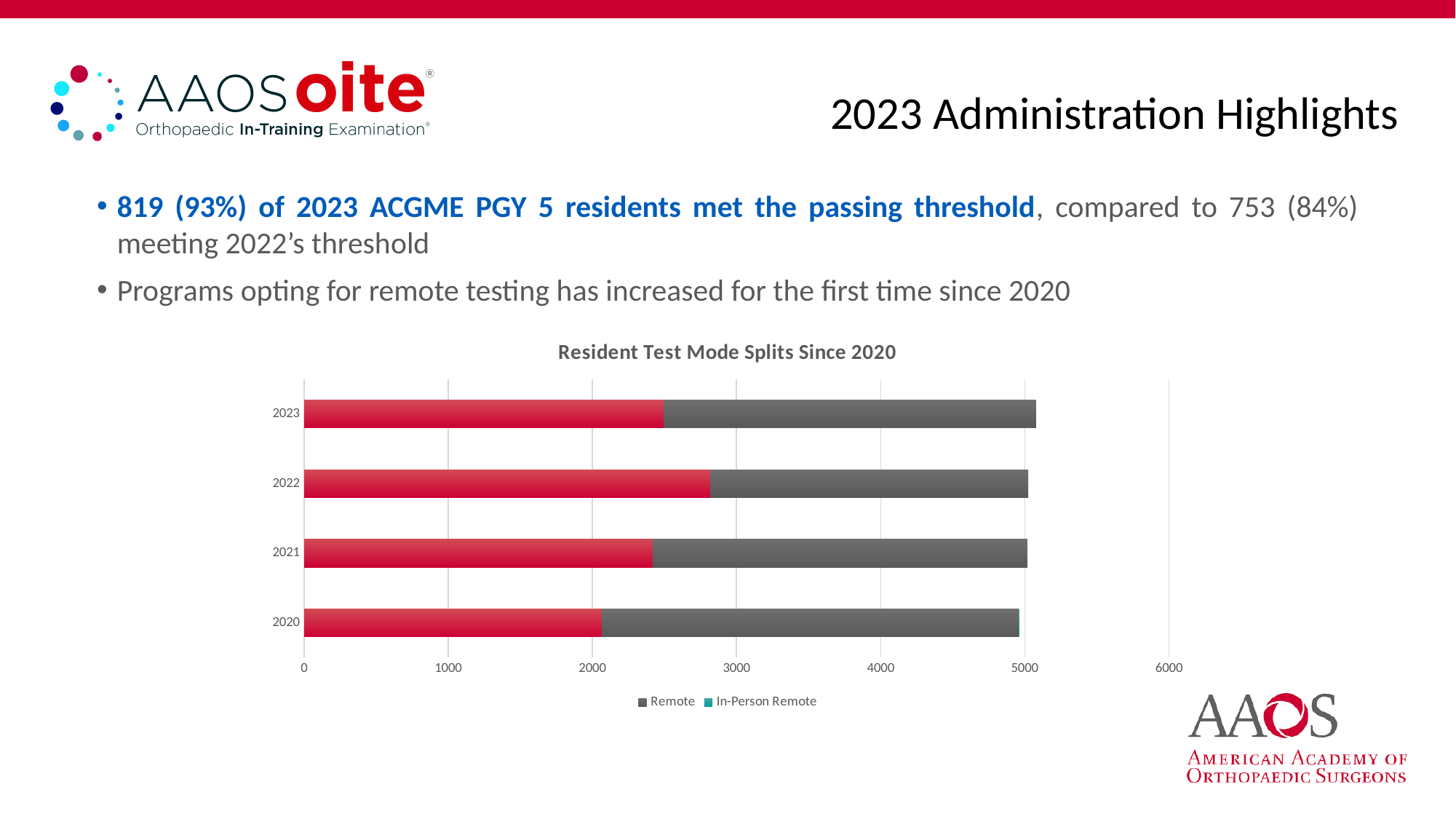
Is the total bar length for 2020 greater or less than 6000? less Which year has the longest red segment? 2022 What is the title of the chart? Resident Test Mode Splits Since 2020 Is the red segment for 2022 greater or less than 2000? greater How many years (categories) are shown on the chart? 4 Is the total bar length for 2023 greater or less than 4000? greater What kind of chart is shown on the slide? Stacked bar chart How many series does the chart legend list? 2 What are the two entries in the chart legend? Remote and In-Person Remote Which year has the shortest red segment? 2020